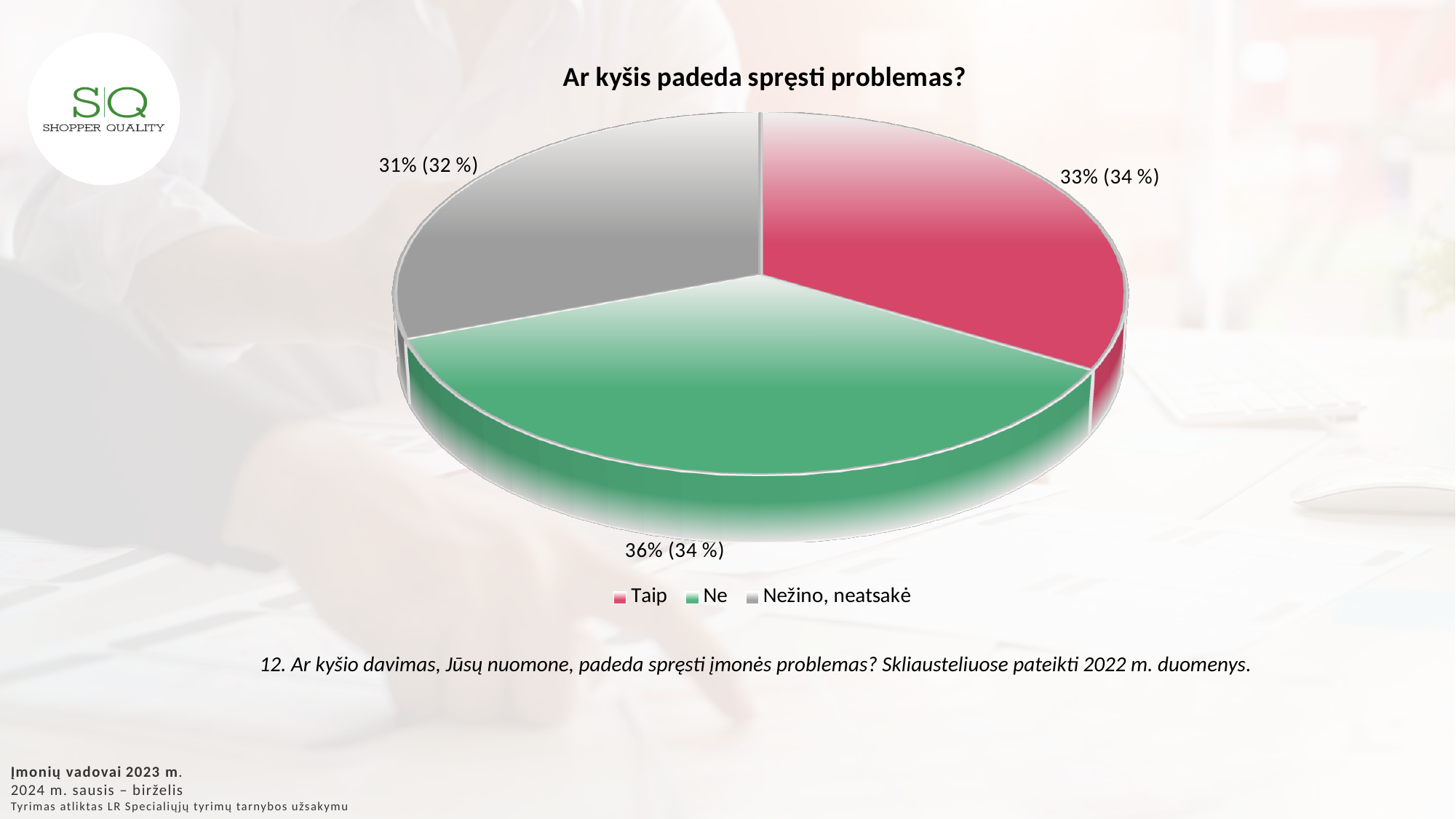
Which category has the largest slice in the pie chart? Ne How many slices does the pie chart have? 3 What is the difference in percentage points between the 2023 shares for "Ne" and "Taip"? 3 What is the title of the chart? Ar kyšis padeda spręsti problemas? Which colour represents "Taip" in the pie chart? red What is the 2023 share for "Taip"? 33% What kind of chart is shown on the slide? pie chart What 2022 value is shown in parentheses for "Nežino, neatsakė"? 32 % What is the 2023 share for "Nežino, neatsakė"? 31% What is the 2023 share for "Ne"? 36% How many entries does the legend list? 3 Which category has the smallest slice in the pie chart? Nežino, neatsakė